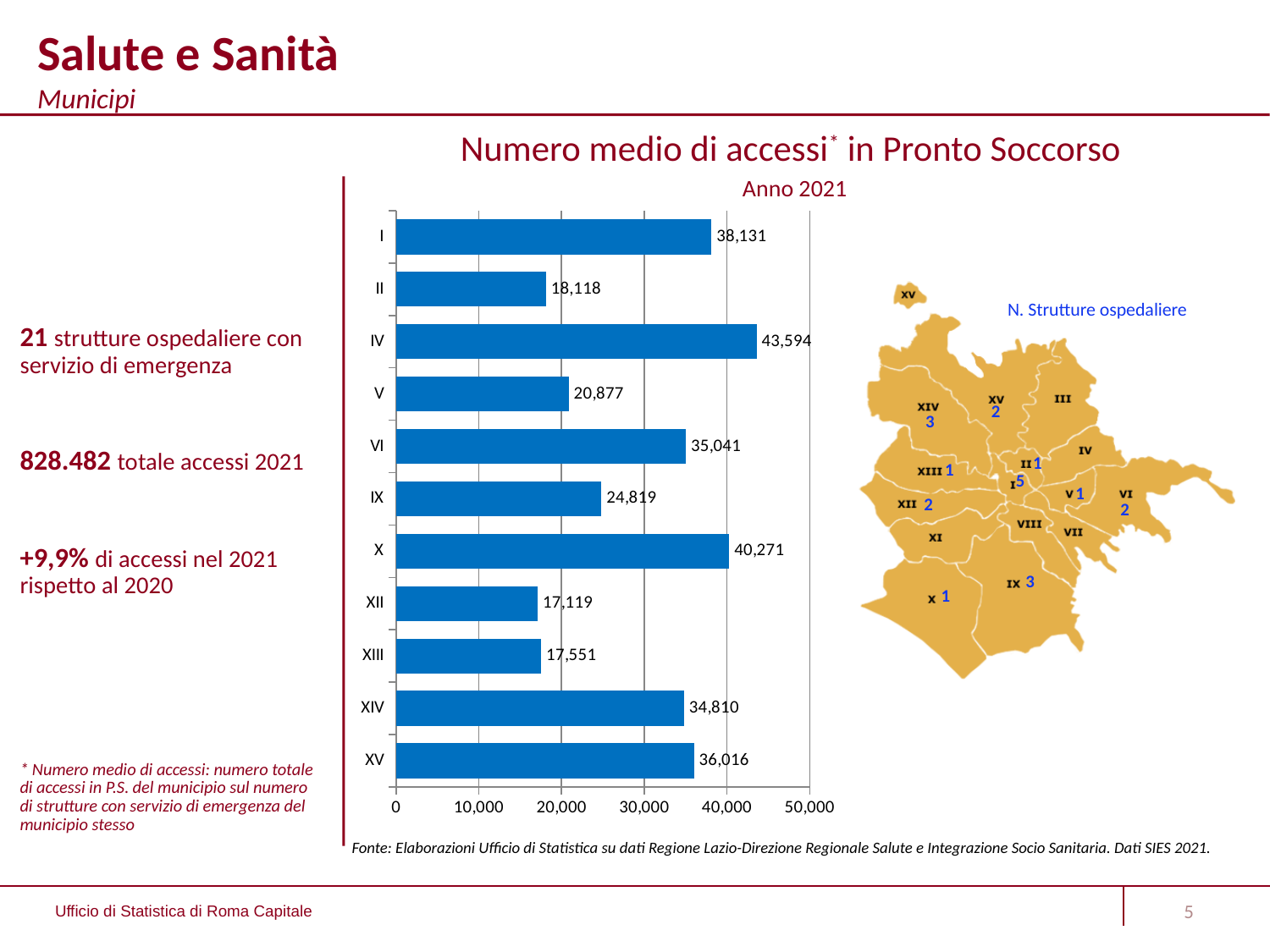
What is the average number of emergency room accesses for Municipio IV? 43,594 How many municipi are shown in the bar chart? 11 What is the value shown for Municipio XIII? 17,551 Which municipio has the lowest average number of accesses? XII What is the difference between the values for Municipio I and Municipio II? 20,013 Which municipio has the highest average number of accesses? IV What is the value shown for Municipio XV? 36,016 What is the value shown for Municipio X? 40,271 Which has a larger value, Municipio VI or Municipio XIV? VI What year does the chart refer to? 2021 Is the value for Municipio IX greater or less than 30,000? less What kind of chart is used to show the average number of accesses? bar chart